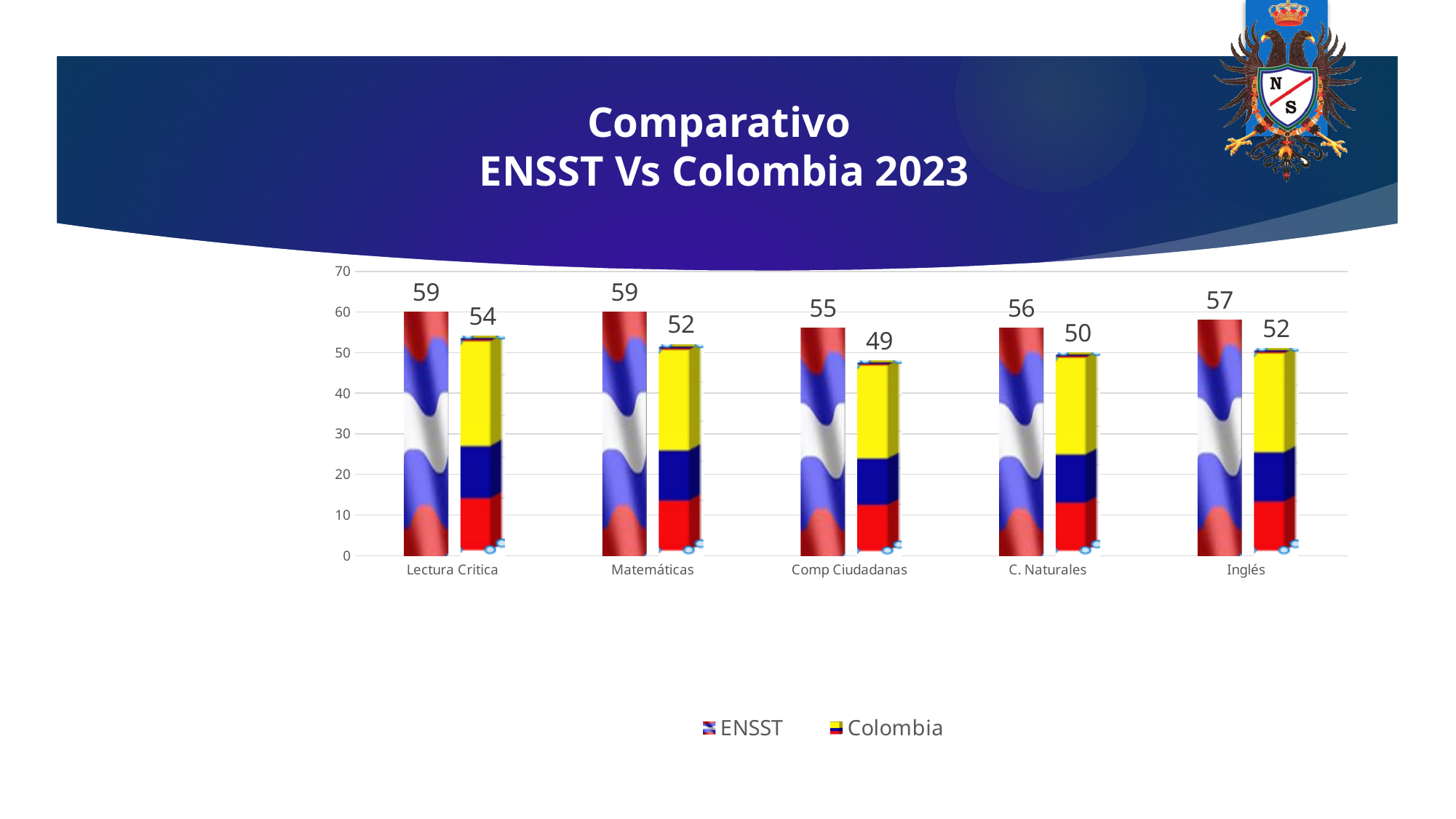
What is the ENSST value for Lectura Critica? 59 What is the Colombia value for Comp Ciudadanas? 49 What kind of chart is shown on the slide? Bar chart What is the difference between the ENSST and Colombia values for Matemáticas? 7 Which is larger for Inglés, the ENSST value or the Colombia value? ENSST What is the difference between the ENSST and Colombia values for Comp Ciudadanas? 6 What is the ENSST value for C. Naturales? 56 Which category has the lowest ENSST value? Comp Ciudadanas How many categories are shown on the x axis? 5 What is the Colombia value for Inglés? 52 How many series does the legend list? 2 Which category has the lowest Colombia value? Comp Ciudadanas